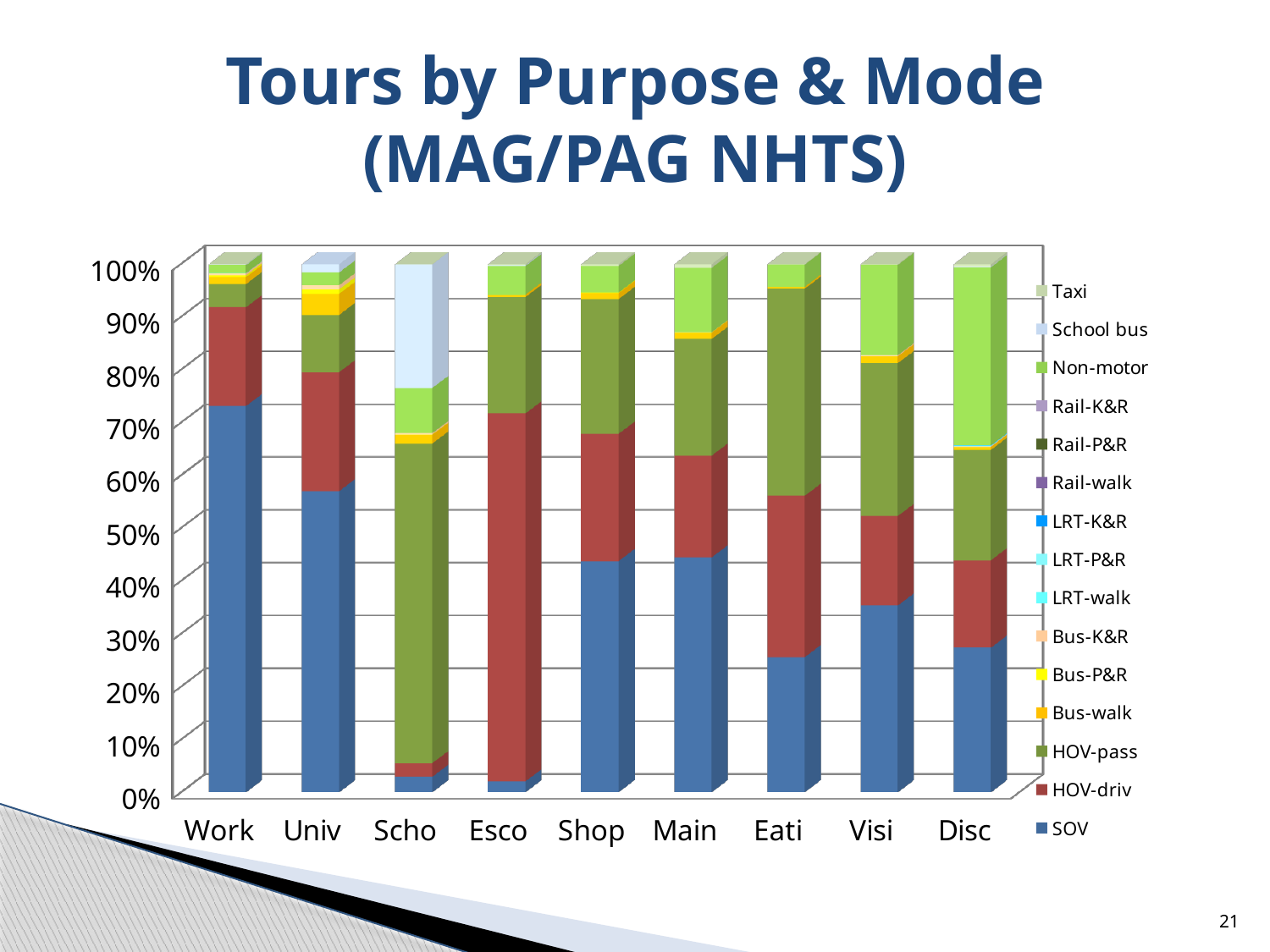
Which tour purpose has the largest Non-motor share? Disc Is the SOV share for Univ greater or less than 50%? greater What is the title of the chart on the slide? Tours by Purpose & Mode (MAG/PAG NHTS) How many mode series does the legend list? 15 Which tour purpose has the largest SOV share? Work How many tour purpose categories are shown along the x axis? 9 Which tour purpose has the largest School bus share? Scho Which has the larger SOV share, Work or Univ? Work What kind of chart is shown on the slide? stacked bar chart Is the SOV share for Work greater or less than 60%? greater Is the SOV share for Esco greater or less than 10%? less Which has the larger Non-motor share, Disc or Work? Disc